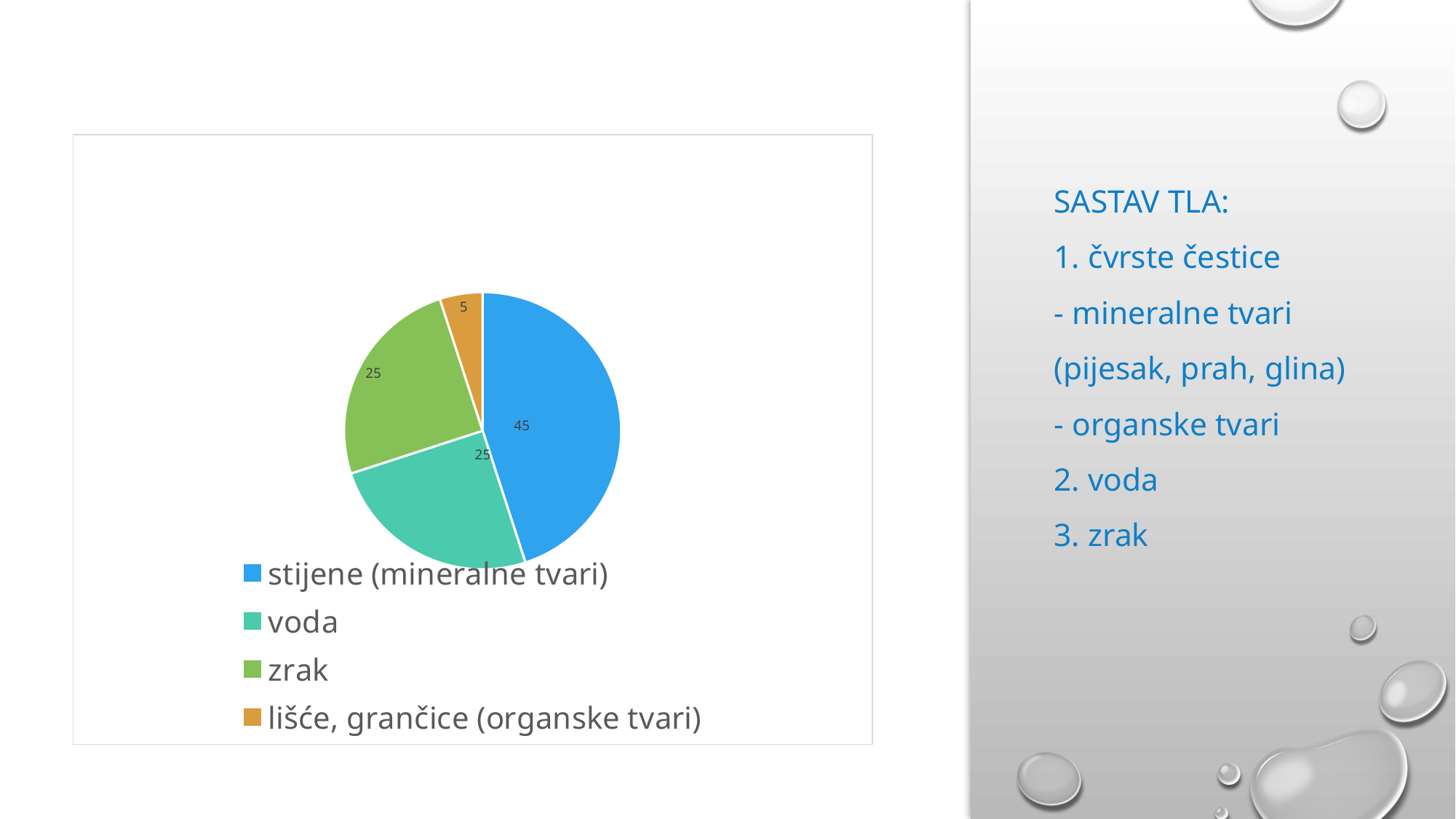
What is the difference between the values for stijene (mineralne tvari) and voda? 20 Which is larger, the value for zrak or the value for lišće, grančice (organske tvari)? zrak Which category has the largest slice of the pie chart? stijene (mineralne tvari) What share of the pie does stijene (mineralne tvari) represent? 45% Which category has the smallest slice of the pie chart? lišće, grančice (organske tvari) What is the value for stijene (mineralne tvari) in the pie chart? 45 What is the value for zrak in the pie chart? 25 What is the value for voda in the pie chart? 25 What colour is the slice for voda in the pie chart? teal What is the value for lišće, grančice (organske tvari) in the pie chart? 5 How many slices does the pie chart have? 4 What kind of chart is shown on the slide? pie chart